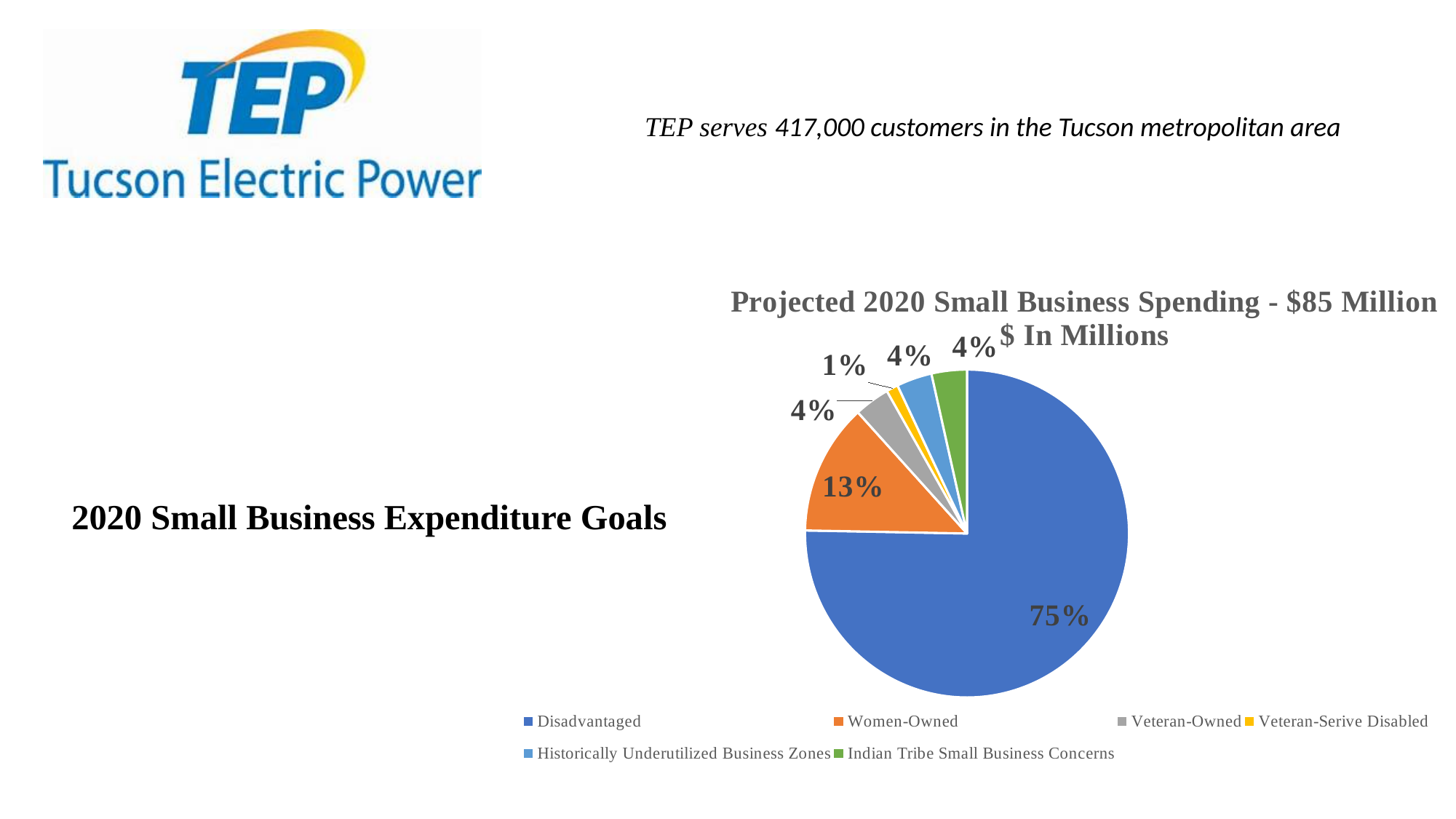
Which category has the smallest slice of the pie? Veteran-Serive Disabled What share of the pie does the Women-Owned slice represent? 13% Which category has the largest slice of the pie? Disadvantaged What share of the pie does the Veteran-Owned slice represent? 4% How many categories does the legend list? 6 What share of the pie does the Veteran-Serive Disabled slice represent? 1% What is the difference in percentage points between the Disadvantaged and Women-Owned slices? 62 Which slice is larger, Women-Owned or Veteran-Owned? Women-Owned What type of chart is shown on the slide? pie chart What is the title of the chart? Projected 2020 Small Business Spending - $85 Million $ In Millions